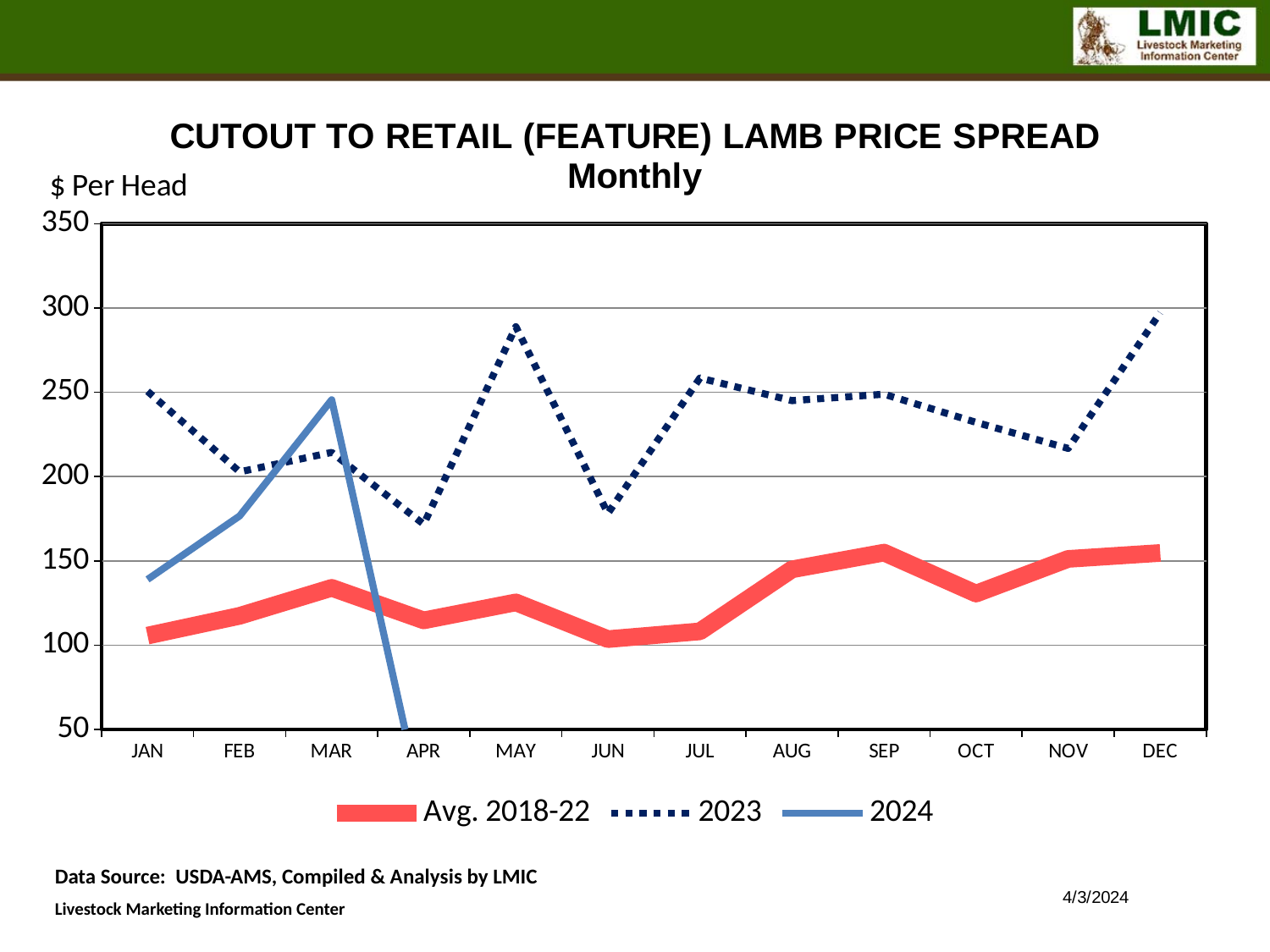
In MAR, which series has the larger value, 2024 or 2023? 2024 Is the Avg. 2018-22 value for JUN greater or less than 150? less Is the 2024 value for MAR greater or less than 200? greater Is the 2023 value for MAY greater or less than 250? greater Does the 2024 series rise or fall from JAN to MAR? rise In which month does the 2024 series reach its highest value? MAR How many series does the legend list? 3 What is the label on the y axis of the chart? $ Per Head How many months are shown along the x axis? 12 What kind of chart is shown on the slide? line chart In JAN, which series has the larger value, 2023 or Avg. 2018-22? 2023